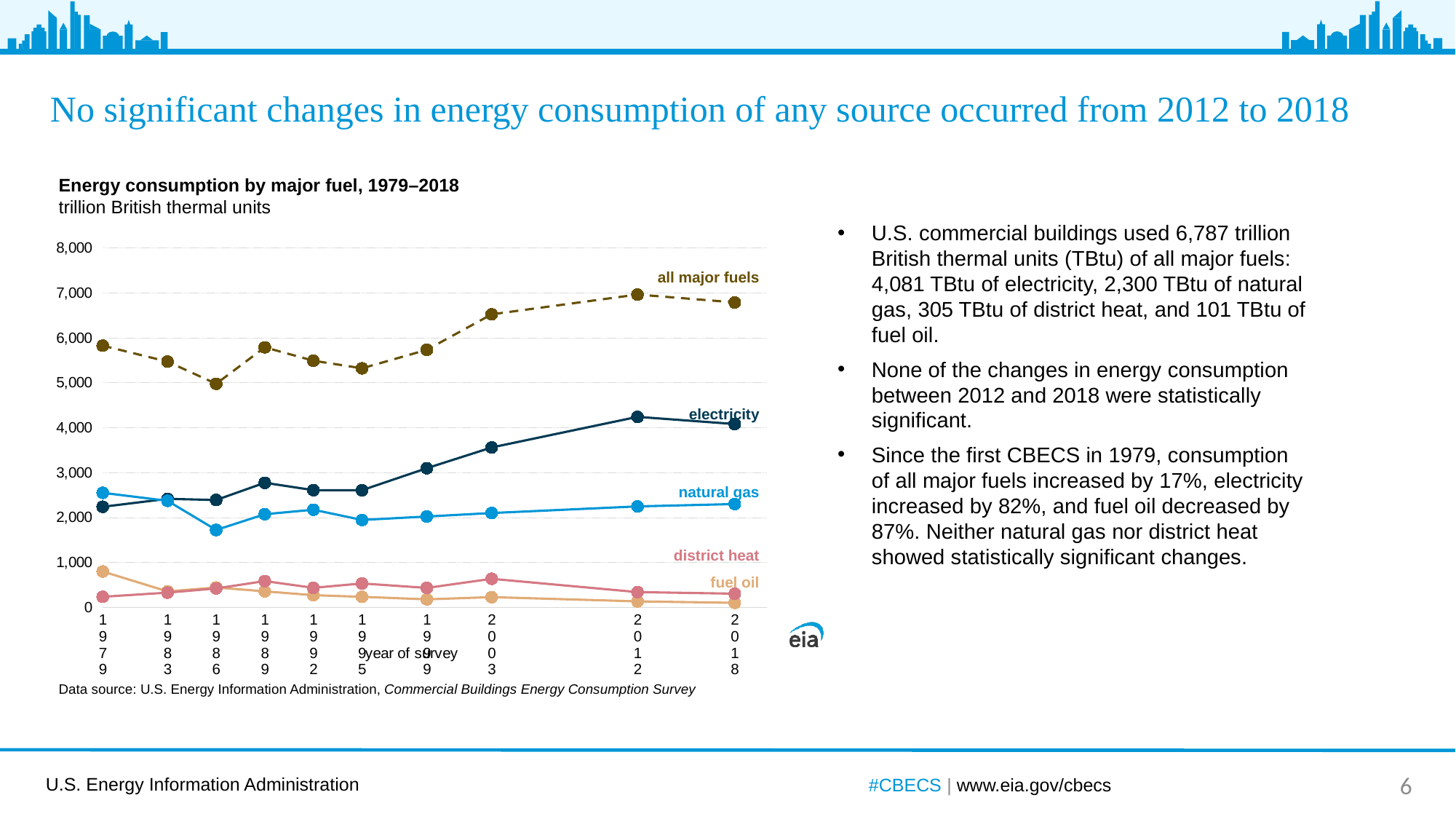
What unit is the chart's y axis measured in? trillion British thermal units Is the value for all major fuels in 1979 greater or less than 5,000? greater Is the value for electricity in 2012 greater or less than 4,000? greater Which series has the lowest value in 2018? fuel oil Is the value for natural gas in 1986 greater or less than 2,000? less Which series has the highest value in 2018? all major fuels How many fuel series are plotted on the chart? 5 What kind of chart is shown on the slide? line chart Does the electricity series rise or fall between 1995 and 2012? rise In 2018, which is larger: electricity or natural gas? electricity How many survey years are plotted along the x axis? 10